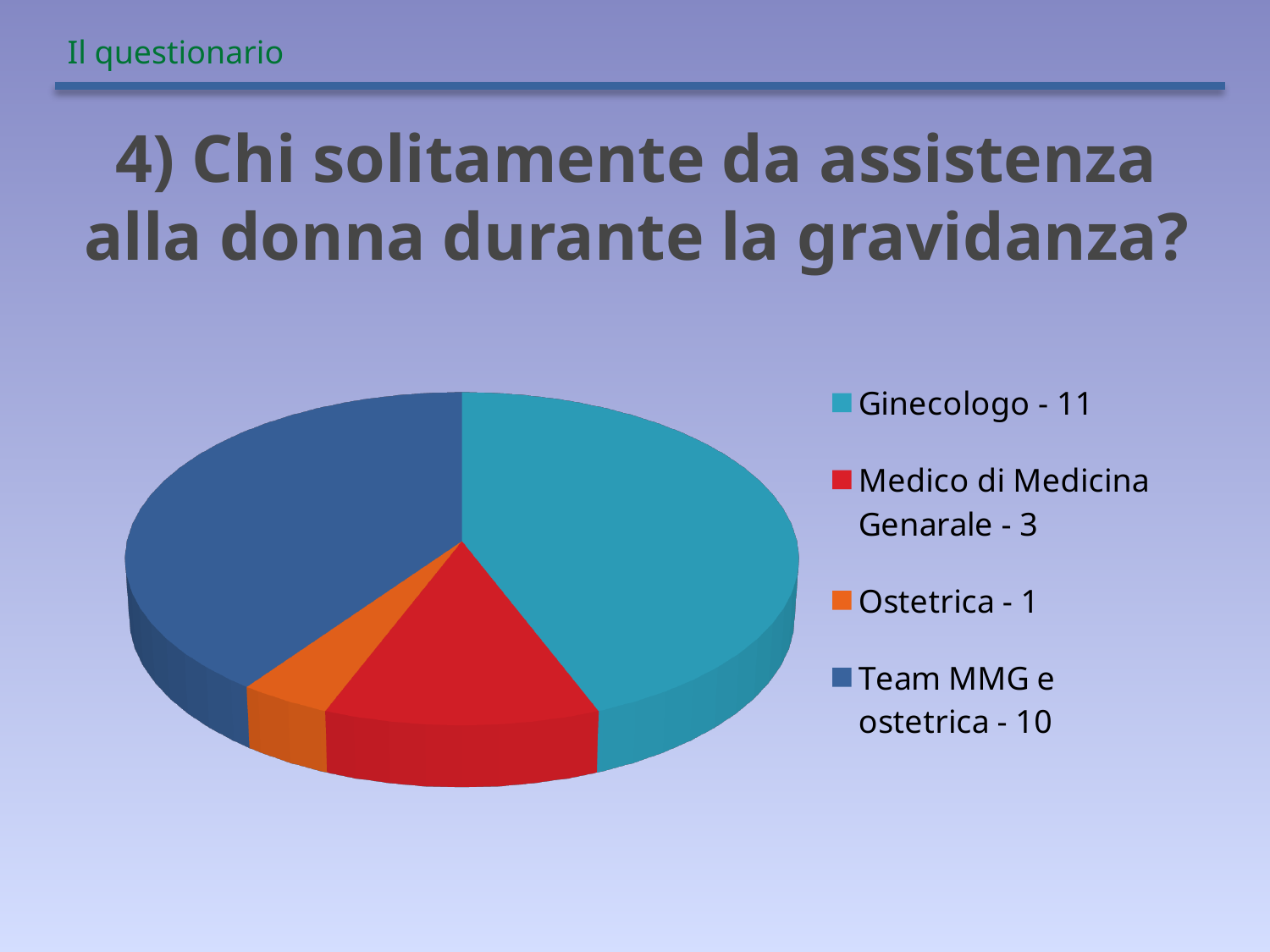
How many categories does the pie chart have? 4 What is the difference between the values for Ginecologo and Team MMG e ostetrica? 1 What value is shown for Team MMG e ostetrica? 10 Which is larger, the value for Medico di Medicina Genarale or the value for Ostetrica? Medico di Medicina Genarale What kind of chart is shown on the slide? Pie chart What value is shown for Ginecologo in the pie chart? 11 Which category has the smallest value in the pie chart? Ostetrica What share of the total does the Ginecologo slice represent? 44% What colour is the slice for Team MMG e ostetrica? Dark blue What value is shown for Ostetrica? 1 Which category has the largest value in the pie chart? Ginecologo What value is shown for Medico di Medicina Genarale? 3